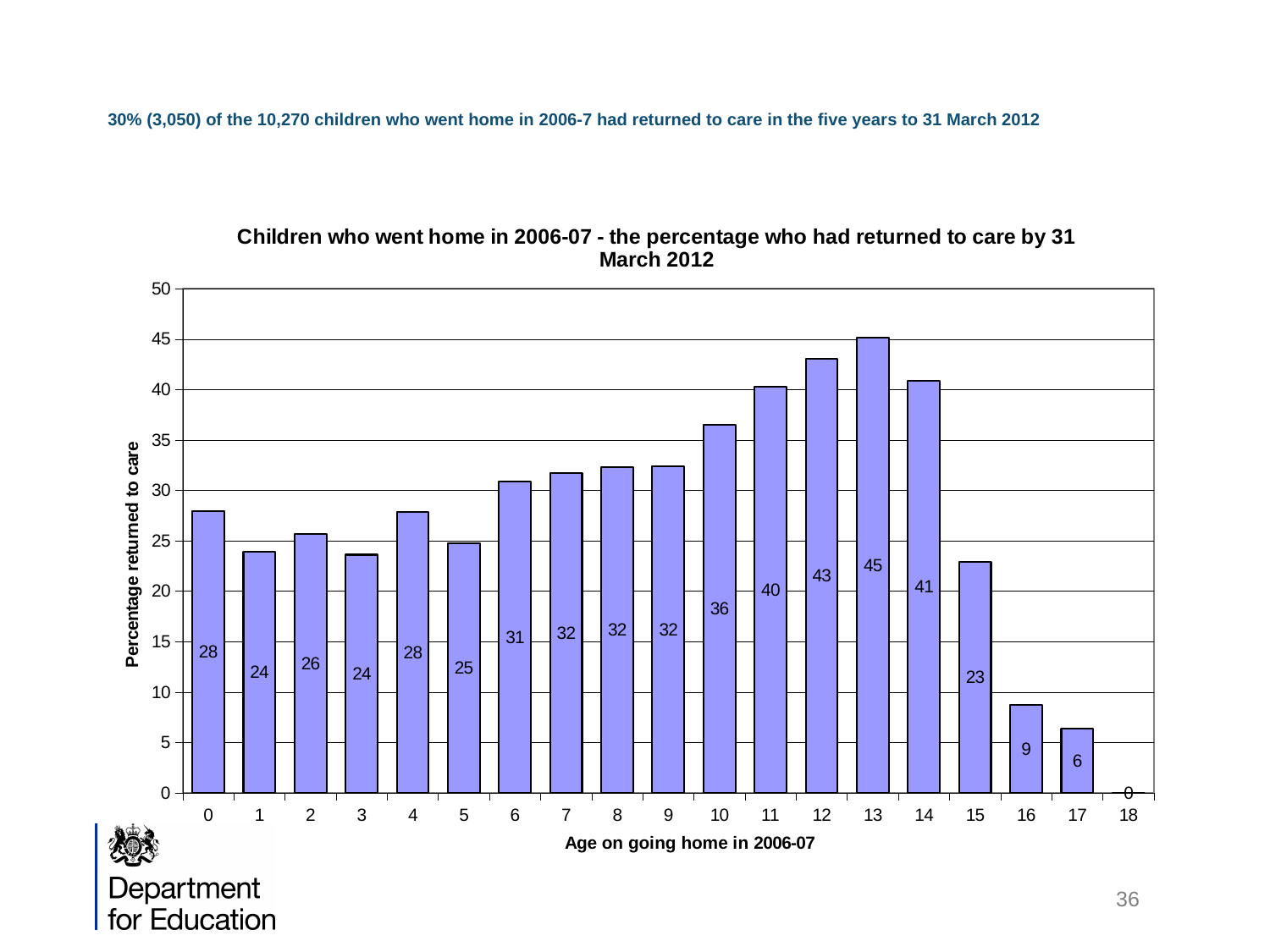
What percentage of children aged 13 on going home had returned to care by 31 March 2012? 45 What is the difference between the values for age 12 and age 1? 19 What kind of chart is shown on the slide? bar chart What is the value shown for age 16? 9 Which age has the lowest percentage returned to care? 18 What is the value shown for age 10? 36 Which is larger, the value for age 0 or the value for age 5? age 0 Is the value for age 14 greater or less than 40? greater Which age has the highest percentage returned to care? 13 How many age categories are shown on the x axis? 19 What is the difference between the values for age 13 and age 15? 22 What is the label of the x axis? Age on going home in 2006-07